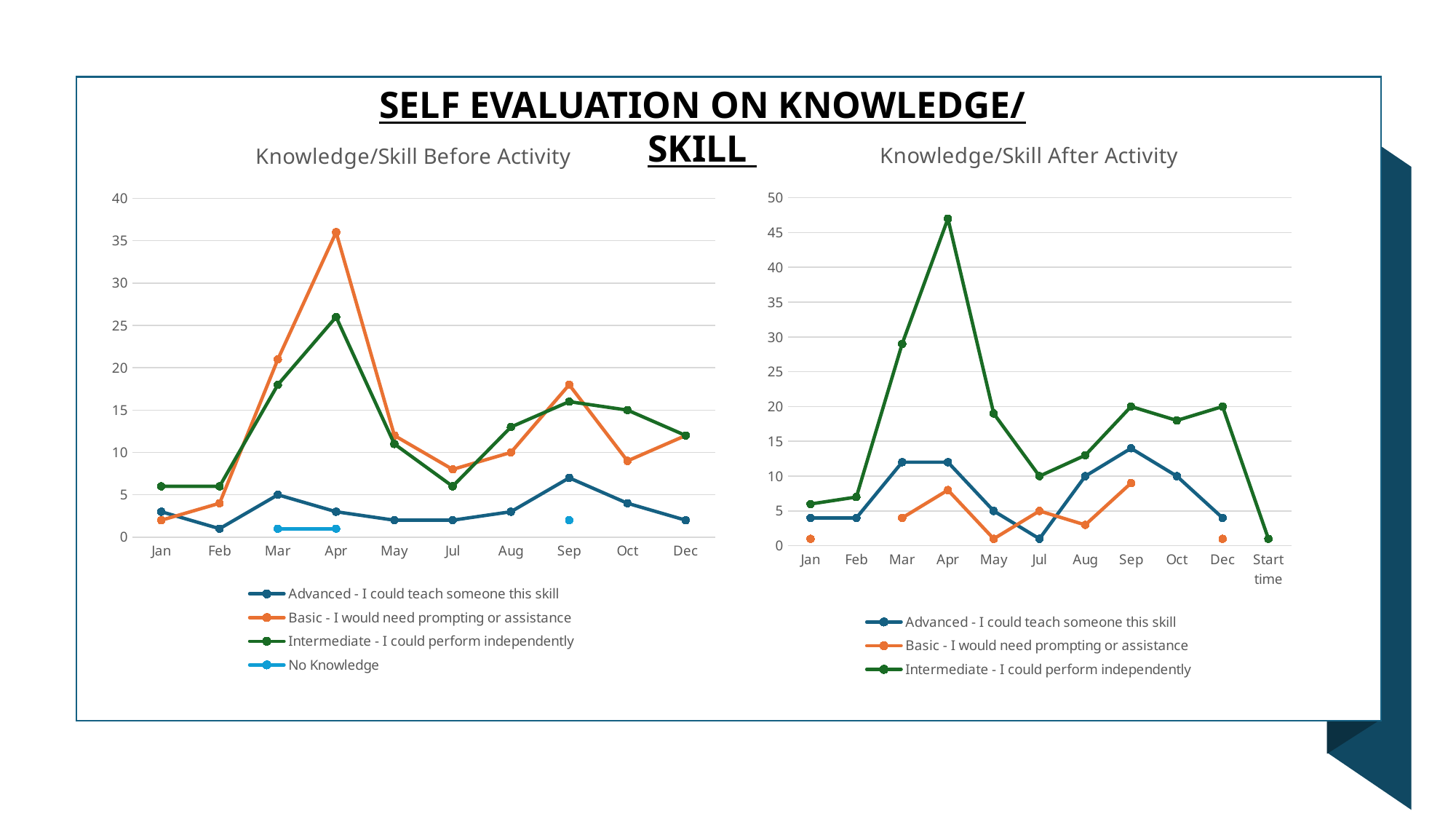
How many categories are on the x axis of the "Knowledge/Skill After Activity" chart? 11 In the "Knowledge/Skill After Activity" chart, is the Intermediate value for Apr greater or less than 40? greater In the "Knowledge/Skill Before Activity" chart, is the Basic value for Apr greater or less than 30? greater How many series does the legend of the "Knowledge/Skill After Activity" chart list? 3 How many series does the legend of the "Knowledge/Skill Before Activity" chart list? 4 What is the title of the chart on the right side of the slide? Knowledge/Skill After Activity In the "Knowledge/Skill After Activity" chart, in which month does the Intermediate series reach its highest value? Apr What kind of chart is the "Knowledge/Skill Before Activity" chart? line chart How many categories are on the x axis of the "Knowledge/Skill Before Activity" chart? 10 In the "Knowledge/Skill Before Activity" chart, which series has the larger value in Apr, Basic or Intermediate? Basic In the "Knowledge/Skill After Activity" chart, does the Intermediate series rise or fall from Apr to Jul? fall In the "Knowledge/Skill Before Activity" chart, in which month does the Basic series reach its highest value? Apr